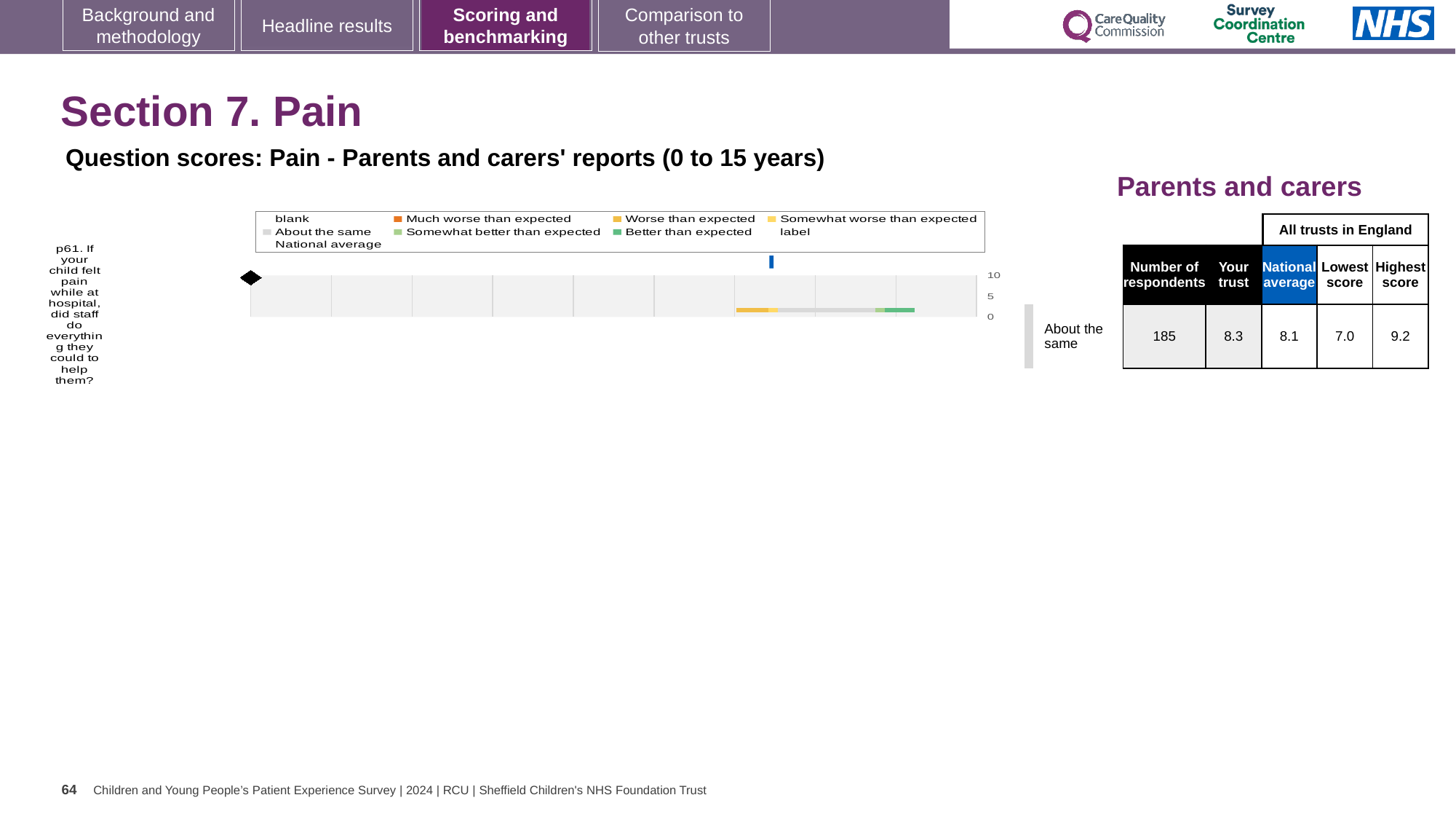
In the table next to the chart, what is the 'Your trust' score for p61? 8.3 What kind of chart is shown on the slide? bar chart How many entries does the chart legend list? 9 Is the 'Your trust' score for p61 larger or smaller than the national average? larger How many questions (categories) are plotted in the chart? 1 What colour does the legend use for 'Better than expected'? green In the table next to the chart, how many respondents answered p61? 185 In the table next to the chart, what is the highest score among all trusts in England for p61? 9.2 In the table next to the chart, what is the lowest score among all trusts in England for p61? 7.0 Which question is plotted in the chart? p61. If your child felt pain while at hospital, did staff do everything they could to help them? What is the difference between the highest score and the lowest score for p61 in the table? 2.2 In the table next to the chart, what is the national average score for p61? 8.1